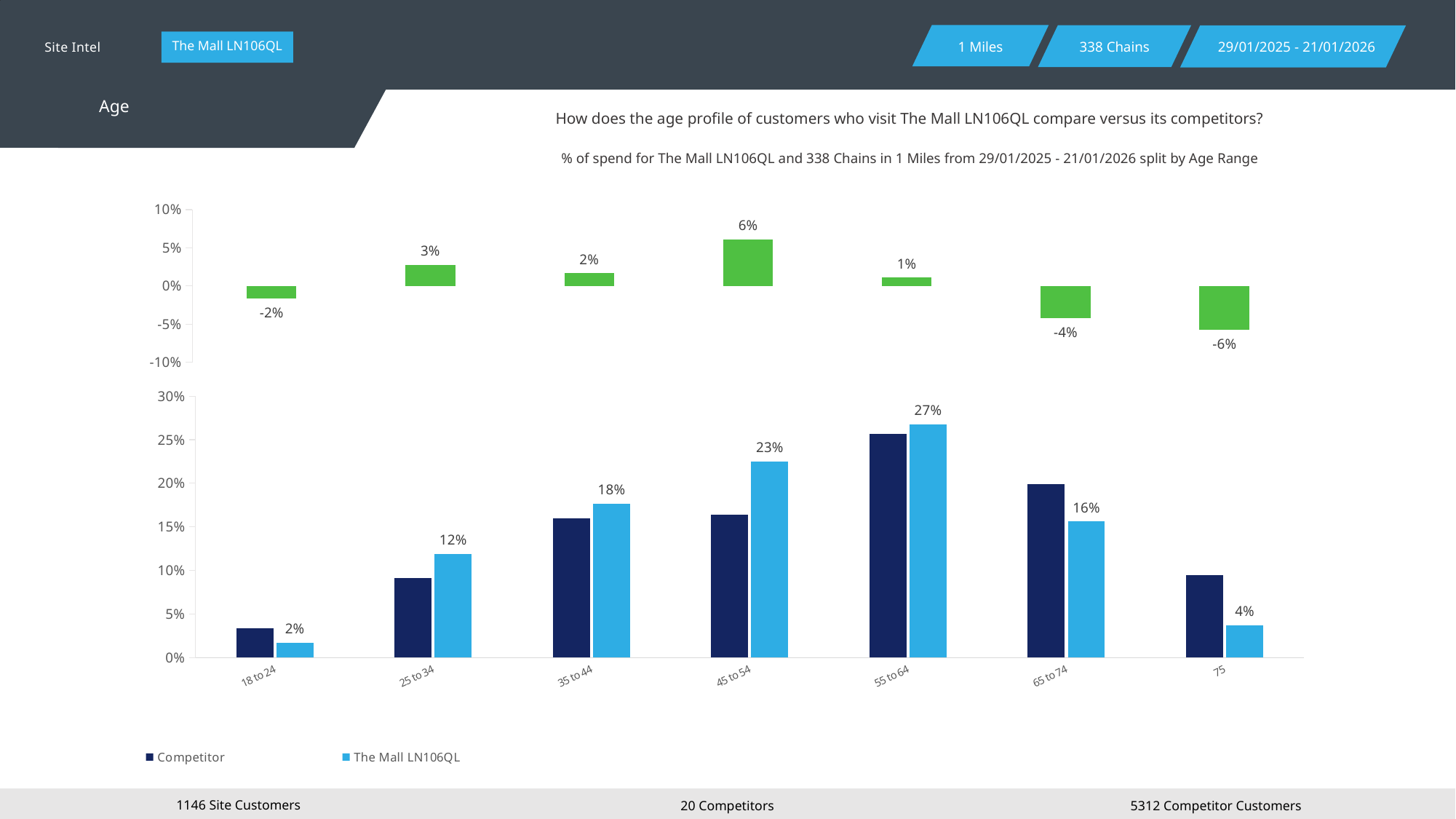
In the top green chart, which age range has the lowest value? 75 In the bottom bar chart, what is the value for The Mall LN106QL in the 25 to 34 age range? 12% In the top green chart, what is the value shown for the 75 age range? -6% In the top green chart, what is the value shown for the 45 to 54 age range? 6% In the bottom bar chart, what is the difference between The Mall LN106QL values for 45 to 54 and 35 to 44? 5% In the bottom bar chart, which age range has the highest value for The Mall LN106QL? 55 to 64 In the bottom bar chart, for the 65 to 74 age range, which is larger: the Competitor bar or The Mall LN106QL bar? Competitor How many age range categories are shown on the x axis of the bottom bar chart? 7 What type of chart is the bottom chart? Bar chart In the bottom bar chart, what is the value for The Mall LN106QL in the 55 to 64 age range? 27% In the bottom bar chart, is the Competitor value for 55 to 64 greater or less than 20%? greater How many series does the legend of the bottom chart list? 2